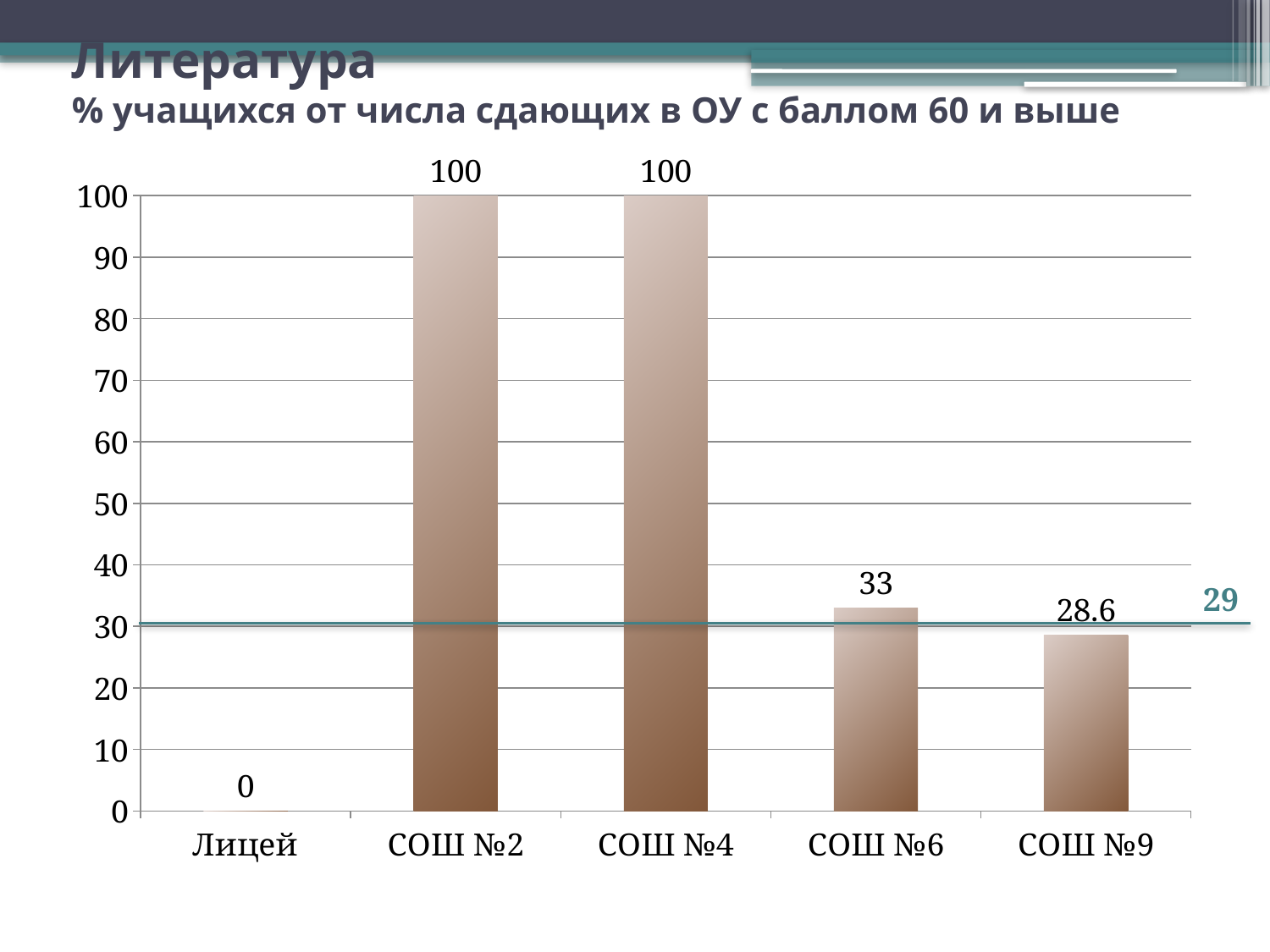
Which category has the lowest value? Лицей What is the value for СОШ №2? 100 How many categories are shown on the x axis? 5 Is the value for СОШ №9 greater or less than 30? less What is the value for Лицей? 0 Which is larger, the value for СОШ №6 or the value for СОШ №9? СОШ №6 What kind of chart is shown on the slide? bar chart What value is labelled on the horizontal reference line across the chart? 29 What is the value for СОШ №6? 33 What is the value for СОШ №9? 28.6 What is the difference between the values for СОШ №6 and СОШ №9? 4.4 What is the difference between the values for СОШ №4 and СОШ №6? 67